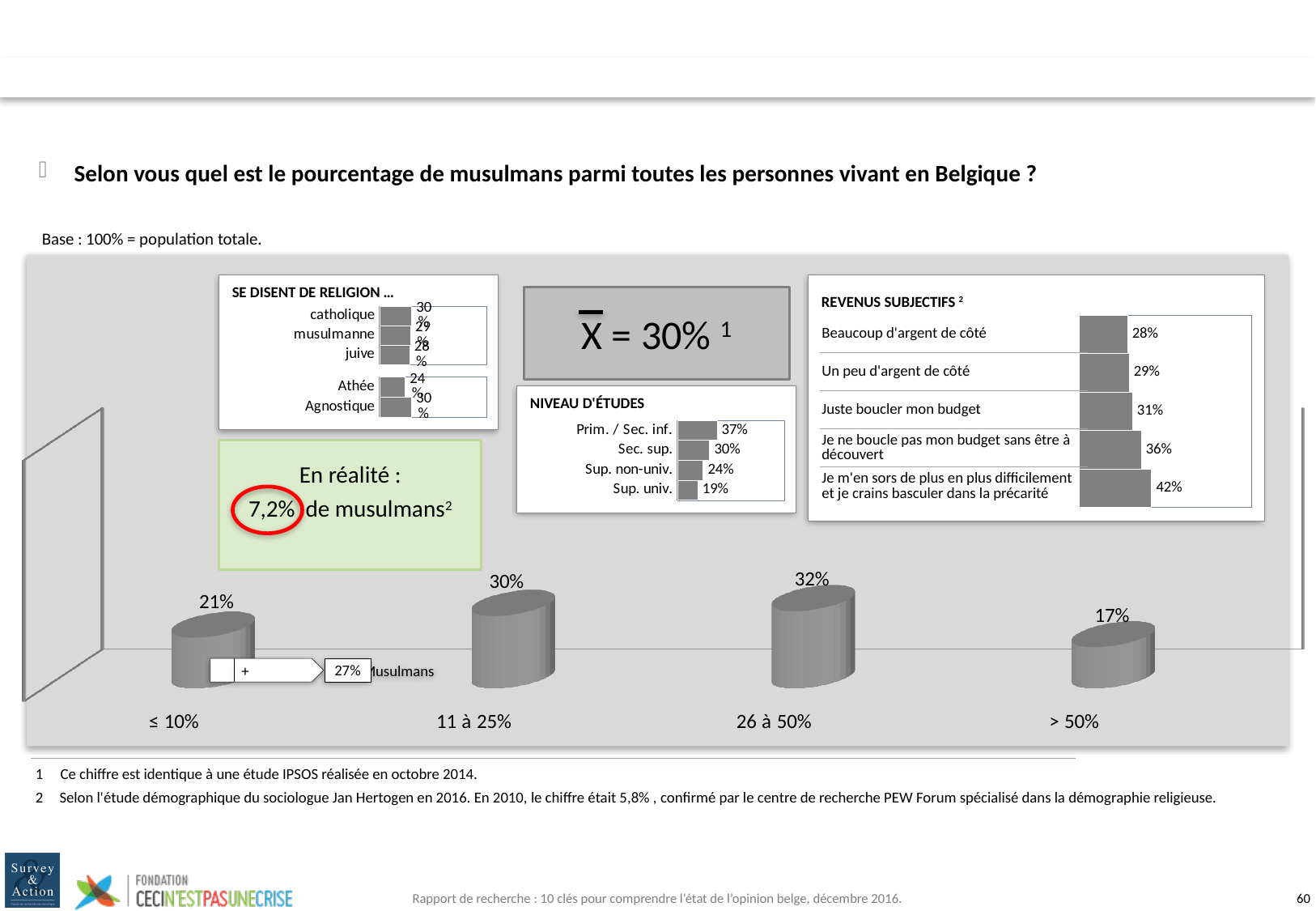
In the main chart at the bottom of the slide, which category has the highest value? 26 à 50% In the 'REVENUS SUBJECTIFS' chart, which category has the highest value? Je m'en sors de plus en plus difficilement et je crains basculer dans la précarité In the main chart at the bottom of the slide, how many categories are shown? 4 In the main chart at the bottom of the slide, what is the value for the category '> 50%'? 17% In the main chart at the bottom of the slide, what is the value for the category '11 à 25%'? 30% In the 'NIVEAU D'ÉTUDES' chart, which category has the highest value? Prim. / Sec. inf. In the 'NIVEAU D'ÉTUDES' chart, what is the value for 'Sup. univ.'? 19% In the 'REVENUS SUBJECTIFS' chart, what is the value for 'Juste boucler mon budget'? 31% In the main chart at the bottom of the slide, what is the difference between the values for '26 à 50%' and '≤ 10%'? 11% In the main chart at the bottom of the slide, which category has the lowest value? > 50% In the 'NIVEAU D'ÉTUDES' chart, do the values rise or fall from 'Prim. / Sec. inf.' to 'Sup. univ.'? fall In the 'REVENUS SUBJECTIFS' chart, which is larger: the value for 'Beaucoup d'argent de côté' or 'Je ne boucle pas mon budget sans être à découvert'? Je ne boucle pas mon budget sans être à découvert